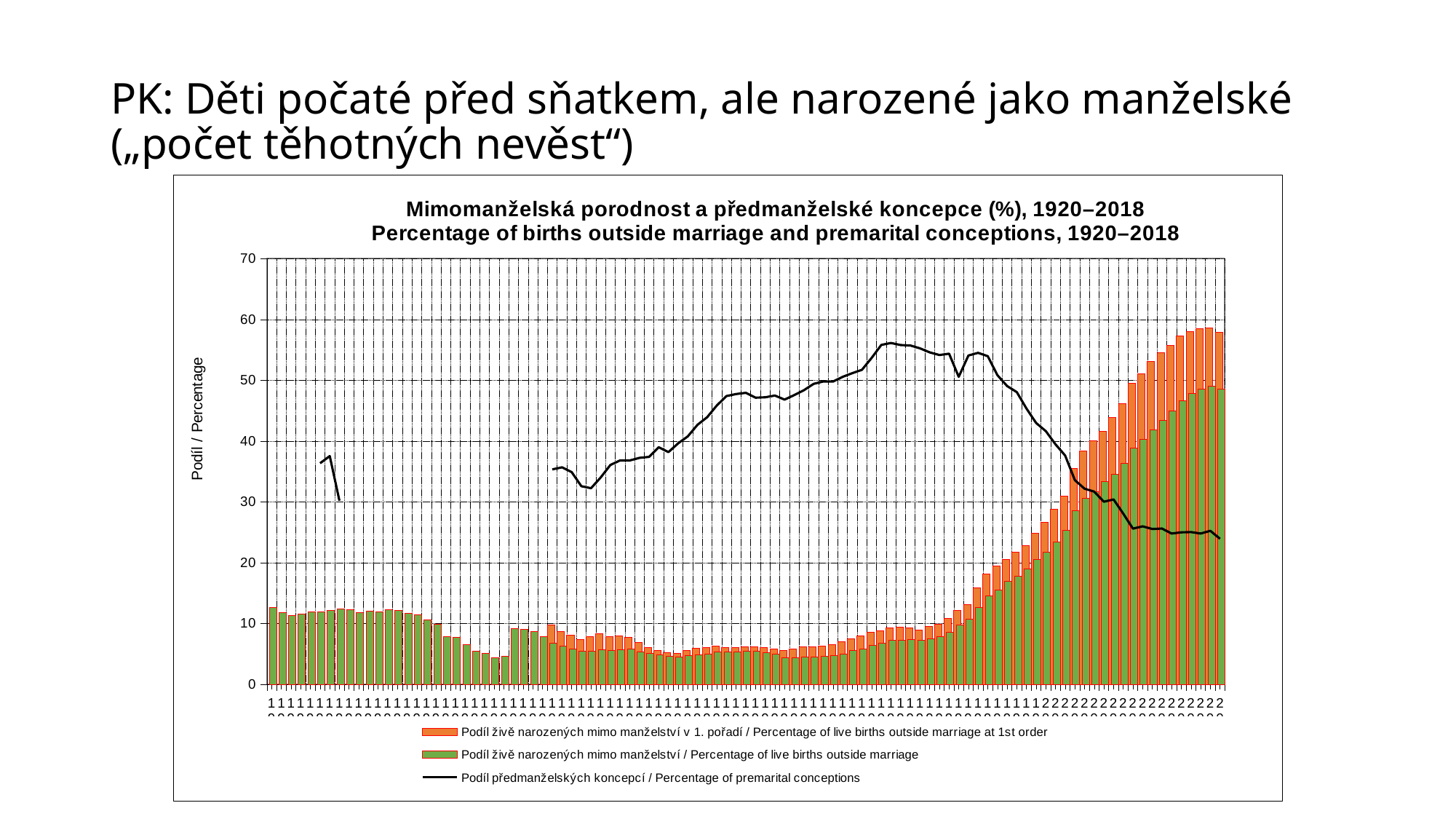
Which series is drawn as the black line? Podíl předmanželských koncepcí / Percentage of premarital conceptions How many series does the legend list? 3 What kind of chart is shown on the slide? Bar chart combined with a line chart What is the title of the vertical axis? Podíl / Percentage Is the tallest orange bar (live births outside marriage at 1st order) greater or less than 50? greater Is the peak value of the black line (premarital conceptions) greater or less than 50? greater What is the highest value shown on the vertical axis? 70 Does the black line rise or fall over the right-hand part of the chart after its peak? fall Do the green bars rise or fall over the right-hand third of the chart? rise Is the last green bar (percentage of live births outside marriage) at the right end greater or less than 40? greater At the right end of the chart, which is larger: the orange bar or the green bar? the orange bar